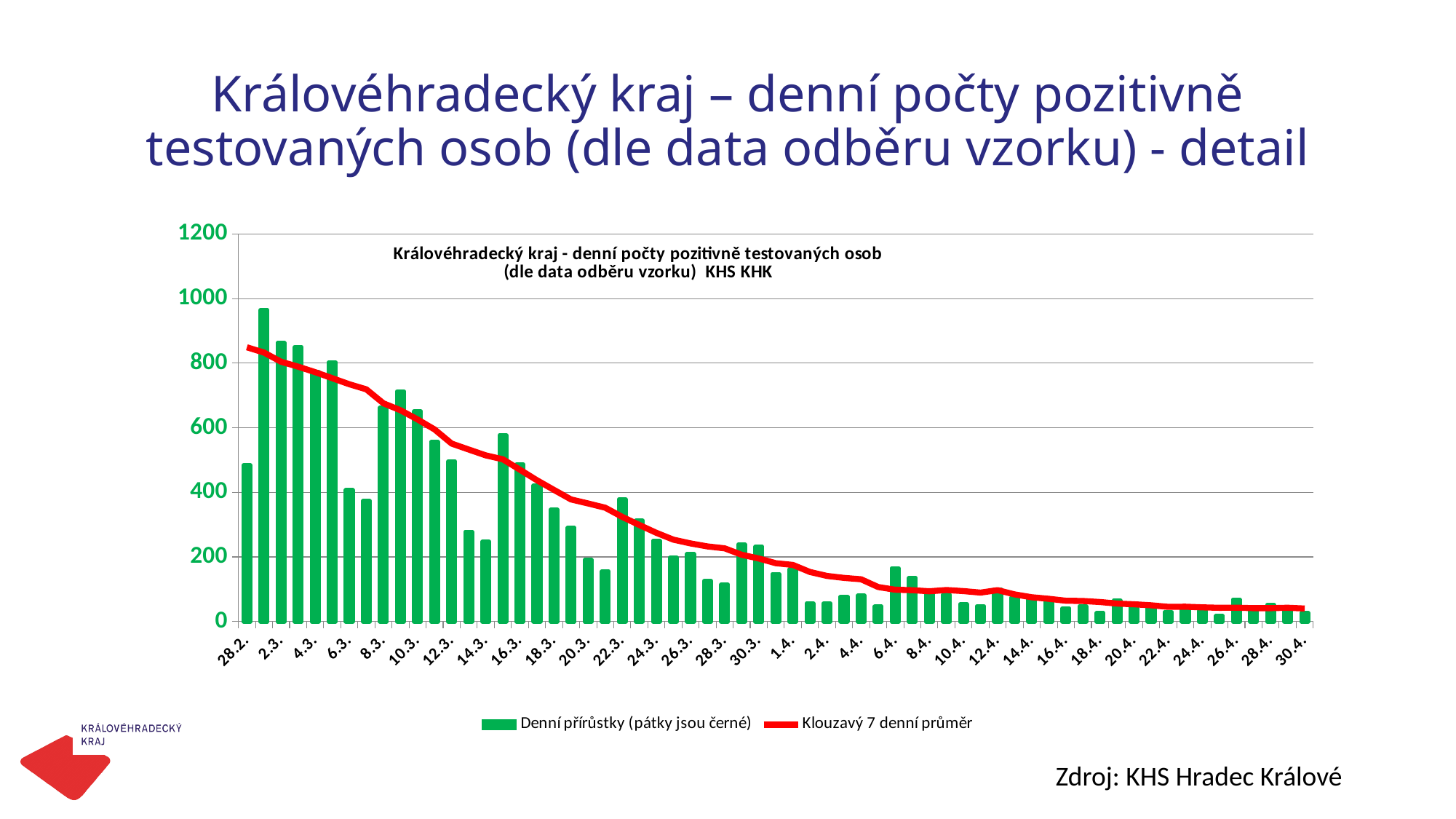
What kind of chart is shown on the slide? bar chart with a line Is the daily value (Denní přírůstky) for 2.3. greater or less than 800? greater Is the daily value (Denní přírůstky) for 30.4. greater or less than 200? less What colour is the 'Klouzavý 7 denní průměr' line? red Is the 7-day moving average (Klouzavý 7 denní průměr) at 28.2. greater or less than 800? greater Which is larger, the daily value for 2.3. or the daily value for 30.4.? 2.3. Do the daily values generally rise or fall from 28.2. to 30.4.? fall What are the two legend entries of the chart? Denní přírůstky (pátky jsou černé); Klouzavý 7 denní průměr How many series does the legend list? 2